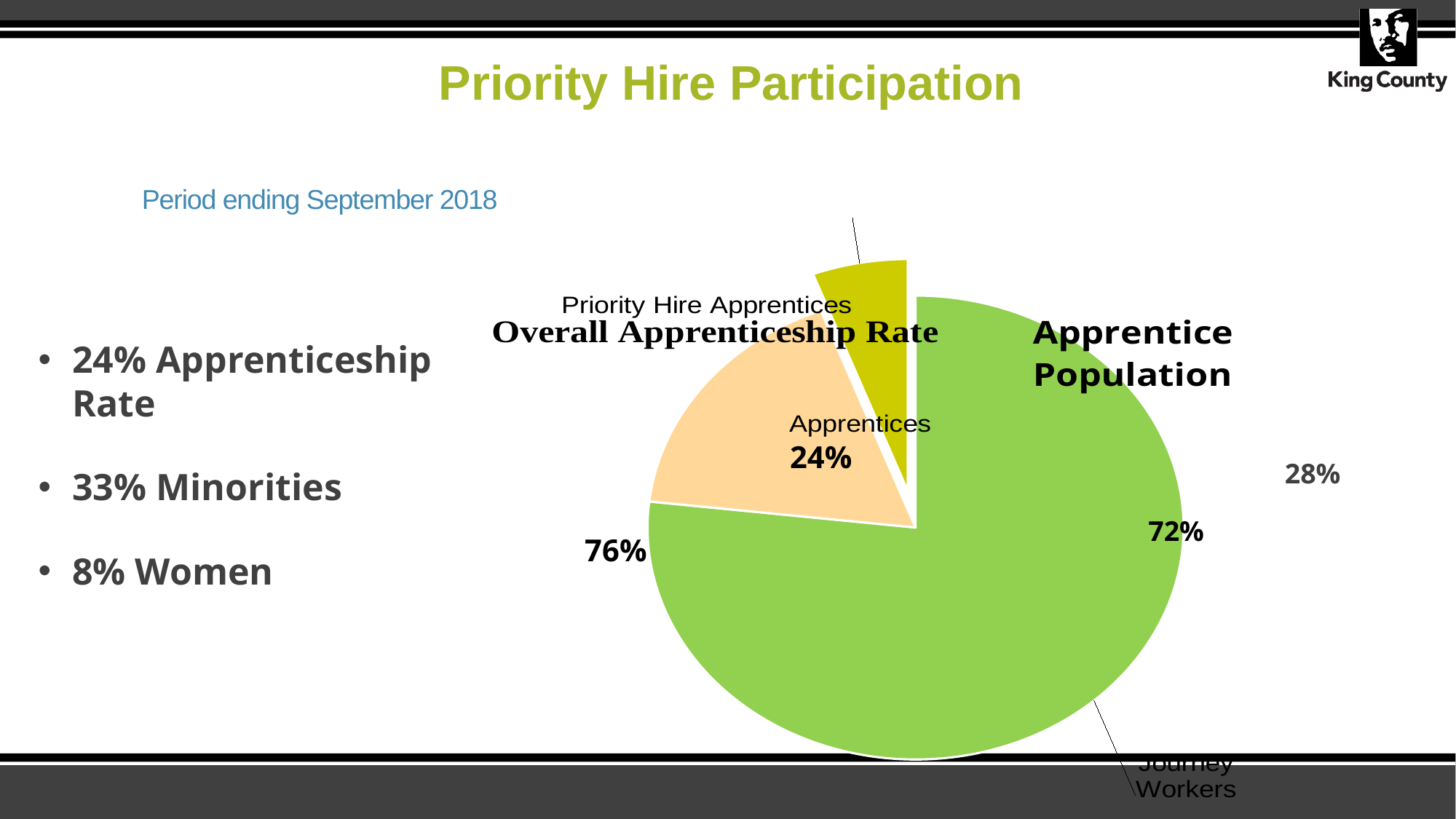
What is the label of the small yellow slice at the top of the chart area? Priority Hire Apprentices In the Overall Apprenticeship Rate chart, which slice is the smallest? Priority Hire Apprentices In the Overall Apprenticeship Rate chart, what is the difference in percentage points between Journey Workers and Apprentices? 52 percentage points What kind of chart is the Overall Apprenticeship Rate chart? Pie chart How many slices does the Overall Apprenticeship Rate pie chart have? 3 In the Overall Apprenticeship Rate chart, which is larger: Journey Workers or Apprentices? Journey Workers In the Overall Apprenticeship Rate chart, which slice is the largest? Journey Workers In the Overall Apprenticeship Rate chart, what percentage is shown for Journey Workers? 76% In the Overall Apprenticeship Rate chart, what percentage is shown for Apprentices? 24%